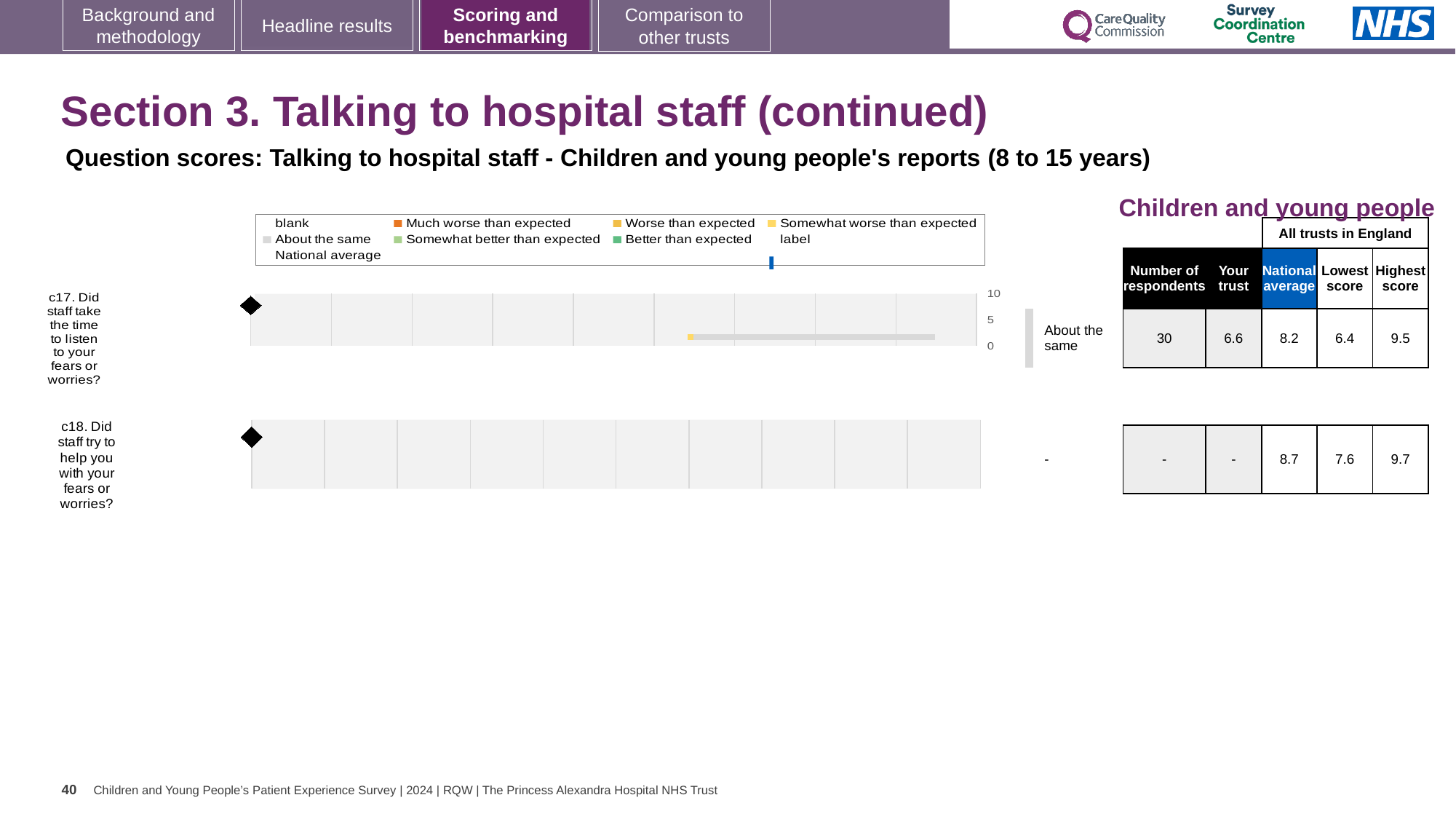
What is the national average for c17 in the table? 8.2 How many questions (categories) are plotted in the chart? 2 What is the 'Your trust' score for c17 in the table? 6.6 What is the highest score across all trusts in England for c18? 9.7 What is the lowest score across all trusts in England for c18? 7.6 What is the difference between the national average and the trust score for c17? 1.6 How many respondents are listed for c17? 30 Which legend entry is shown in orange? Much worse than expected What kind of chart is shown on the slide? bar chart Which is larger for c17: the trust score or the national average? national average What is the benchmark category shown for c17 (Did staff take the time to listen to your fears or worries)? About the same How many entries does the chart legend list? 9